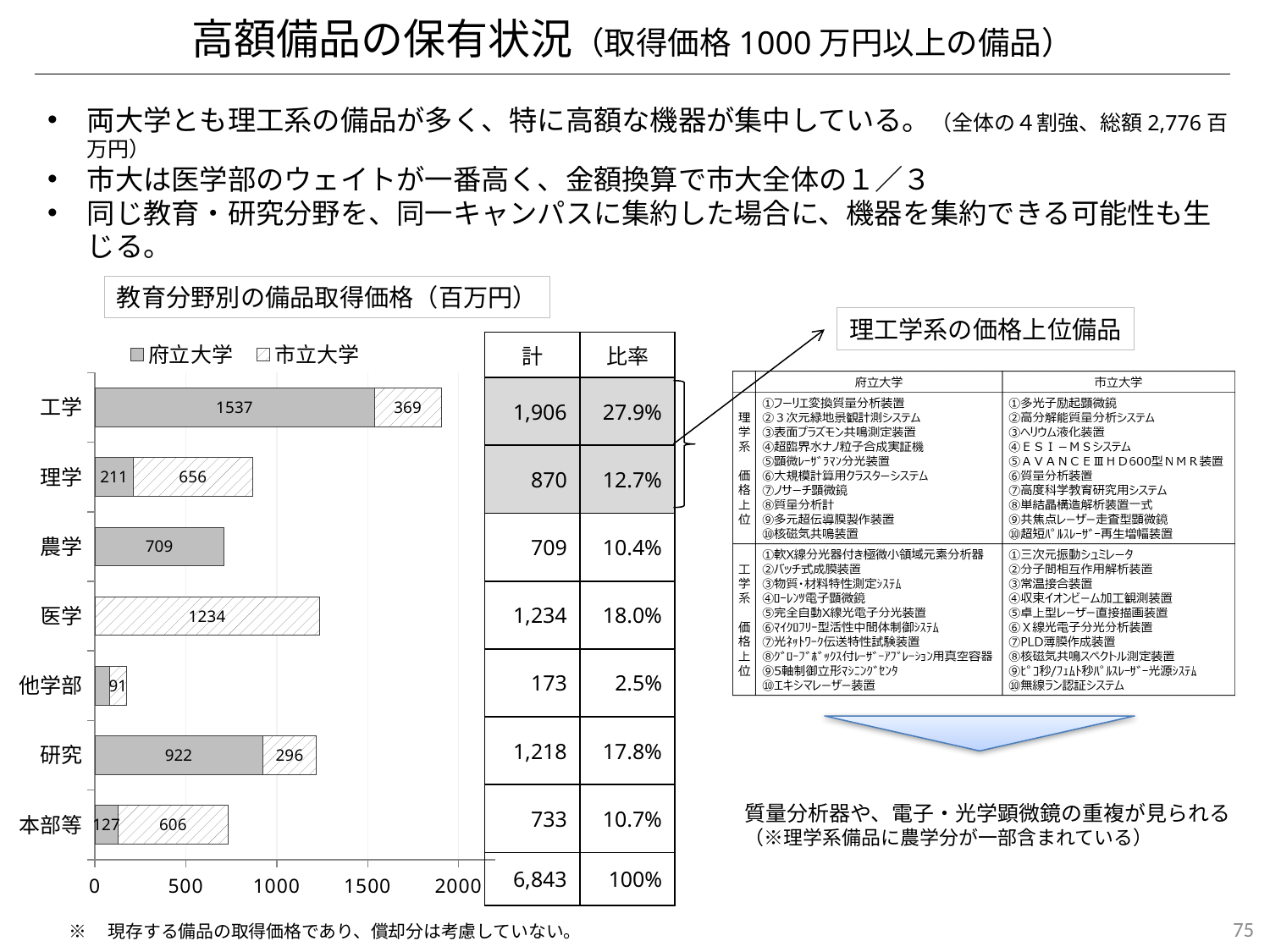
What is the 市立大学 value for 理学? 656 What kind of chart is shown on the slide? bar chart What is the total of the stacked bar for 研究? 1218 Which category has the highest 府立大学 value? 工学 Which is larger: the 府立大学 value for 本部等 or the 市立大学 value for 本部等? 市立大学 How many series does the chart legend list? 2 What is the 市立大学 value for 医学? 1234 What is the 府立大学 value for 工学? 1537 How many categories are shown on the chart's vertical axis? 7 What is the title of the chart? 教育分野別の備品取得価格（百万円） Is the total stacked bar for 農学 greater or less than 1000? less What is the difference between the 府立大学 value for 工学 and the 市立大学 value for 工学? 1168